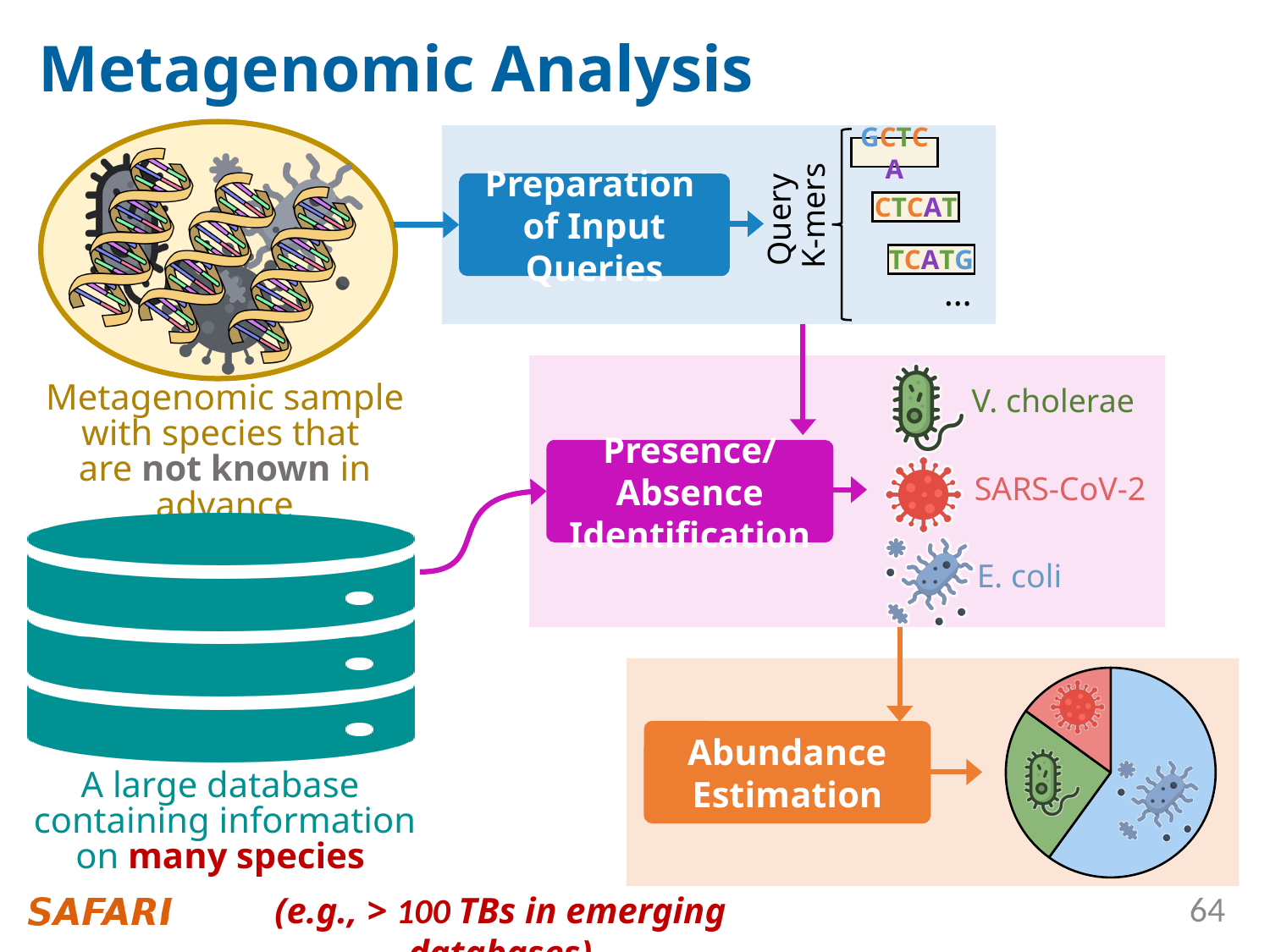
How many slices does the pie chart in the Abundance Estimation box have? 3 Which icon appears in the smallest slice of the pie chart in the Abundance Estimation box? the SARS-CoV-2 icon Which icon appears in the largest slice of the pie chart in the Abundance Estimation box? the E. coli icon In the pie chart in the Abundance Estimation box, which colour slice is the largest? blue What kind of chart is shown in the Abundance Estimation box at the bottom right of the slide? pie chart In the pie chart in the Abundance Estimation box, is the blue slice more or less than half of the pie? more In the pie chart in the Abundance Estimation box, which colour slice is the smallest? red In the pie chart in the Abundance Estimation box, is the blue slice larger or smaller than the green slice? larger